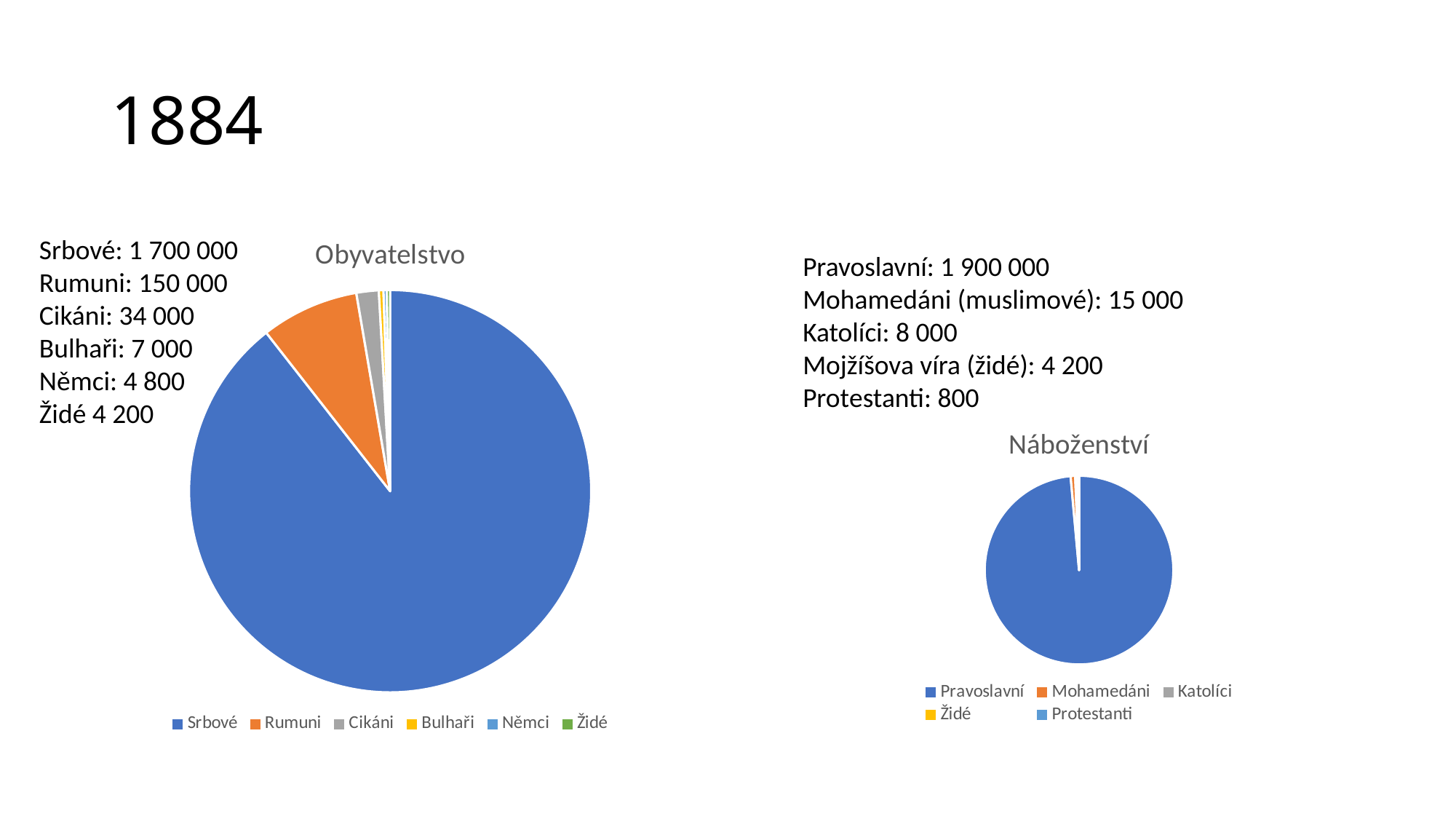
In the "Obyvatelstvo" chart, what is the value for Rumuni? 150 000 In the "Obyvatelstvo" chart, what is the value for Cikáni? 34 000 In the "Náboženství" chart, which category has the smallest value? Protestanti In the "Obyvatelstvo" chart, which category has the largest slice? Srbové How many entries does the legend of the "Náboženství" chart list? 5 How many categories does the "Obyvatelstvo" pie chart have? 6 What colour is the Rumuni slice in the "Obyvatelstvo" chart? orange In the "Náboženství" chart, what is the value for Katolíci? 8 000 In the "Obyvatelstvo" chart, what is the difference between the values for Bulhaři and Němci? 2 200 In the "Náboženství" chart, which category has the largest slice? Pravoslavní In the "Náboženství" chart, which is larger: Mohamedáni or Katolíci? Mohamedáni What kind of chart is the "Obyvatelstvo" chart? pie chart